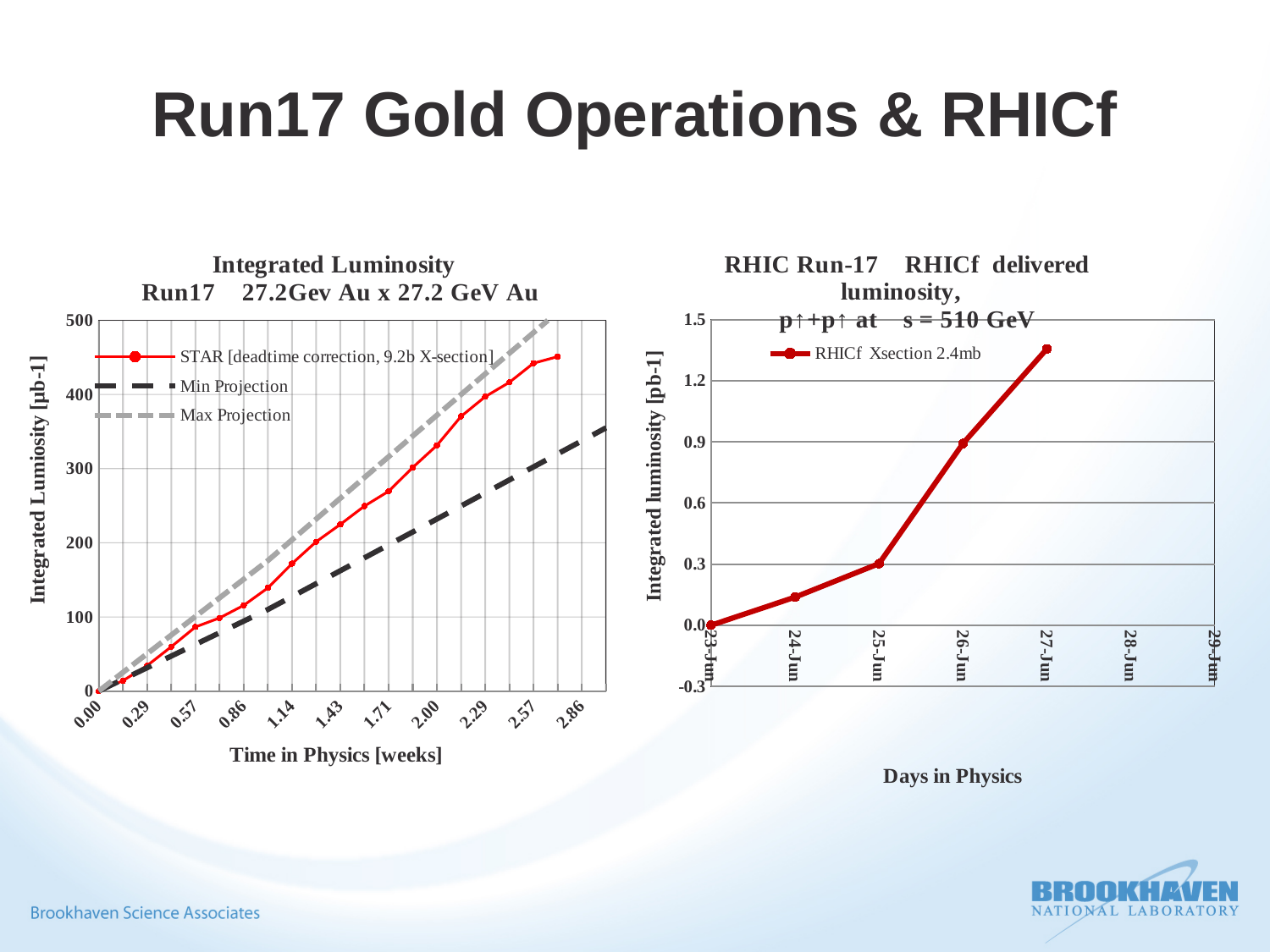
In the left chart ('Integrated Luminosity Run17'), does the STAR series rise or fall as time in physics increases? rise How many series does the legend of the right chart ('RHIC Run-17 RHICf delivered luminosity') list? 1 In the left chart ('Integrated Luminosity Run17'), which series is shown as a grey dashed line? Max Projection In the left chart ('Integrated Luminosity Run17'), at 2.00 weeks, which is higher: Max Projection or Min Projection? Max Projection How many dates are labelled on the x axis of the right chart ('RHIC Run-17 RHICf delivered luminosity')? 7 What is the x-axis label of the left chart ('Integrated Luminosity Run17')? Time in Physics [weeks] In the left chart ('Integrated Luminosity Run17'), is the Min Projection value at 2.86 weeks greater or less than 300? greater What kind of chart is the 'Integrated Luminosity Run17' chart on the left? line chart In the left chart ('Integrated Luminosity Run17'), is the STAR value at 2.57 weeks greater or less than 400? greater In the right chart ('RHIC Run-17 RHICf delivered luminosity'), is the value on 24-Jun greater or less than 0.3? less How many series does the legend of the left chart ('Integrated Luminosity Run17') list? 3